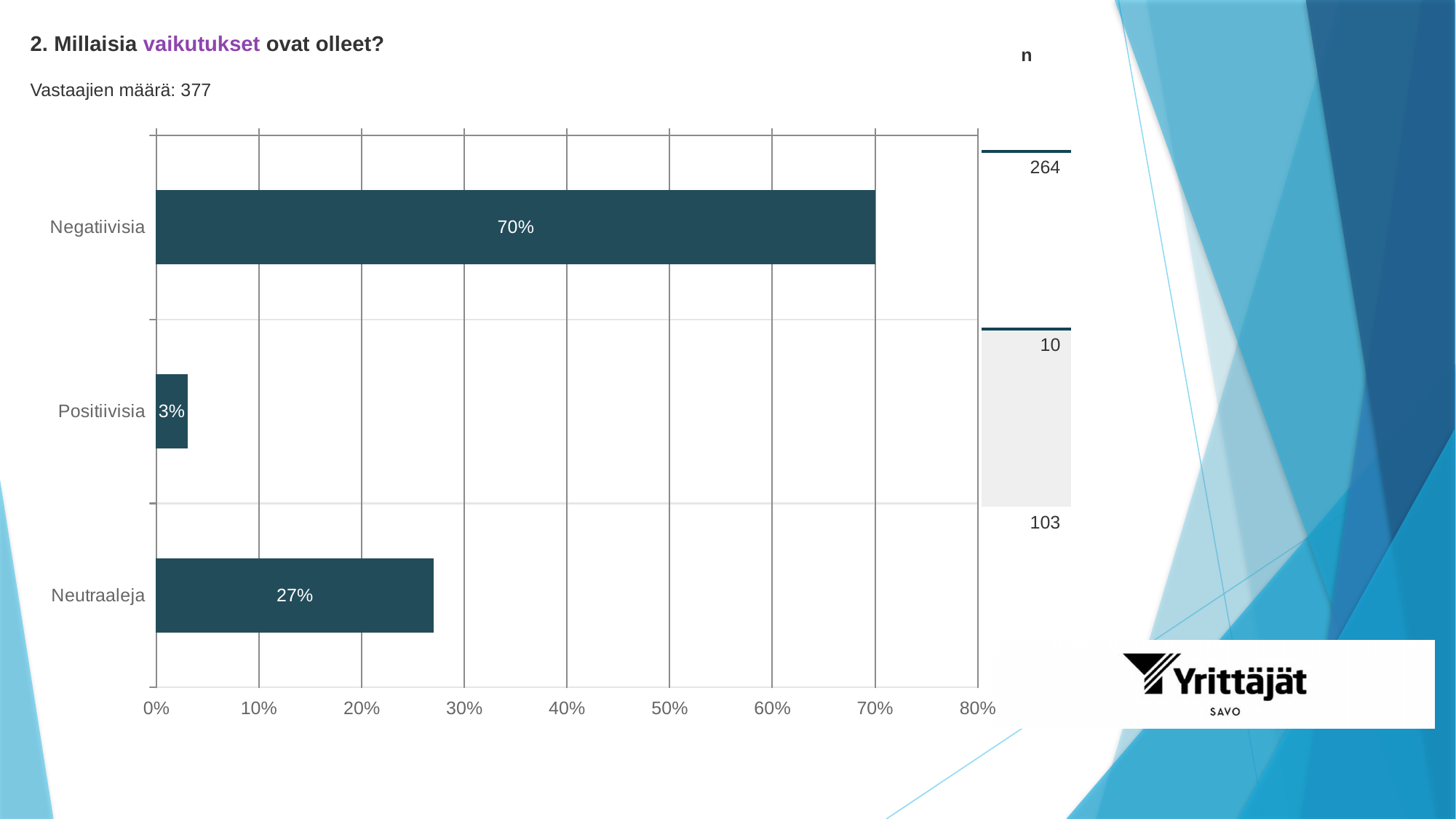
What percentage is shown for Neutraaleja? 27% What kind of chart is shown on the slide? bar chart Which category has the lowest percentage? Positiivisia What percentage is shown for Positiivisia? 3% What percentage is shown for Negatiivisia? 70% How many categories are shown in the chart? 3 Which category has the highest percentage? Negatiivisia What is the difference in percentage points between Negatiivisia and Neutraaleja? 43 What is the n value shown for Negatiivisia? 264 Which is larger, the value for Neutraaleja or the value for Positiivisia? Neutraaleja What is the number of respondents (Vastaajien määrä) stated on the slide? 377 Is the value for Neutraaleja greater or less than 30%? less